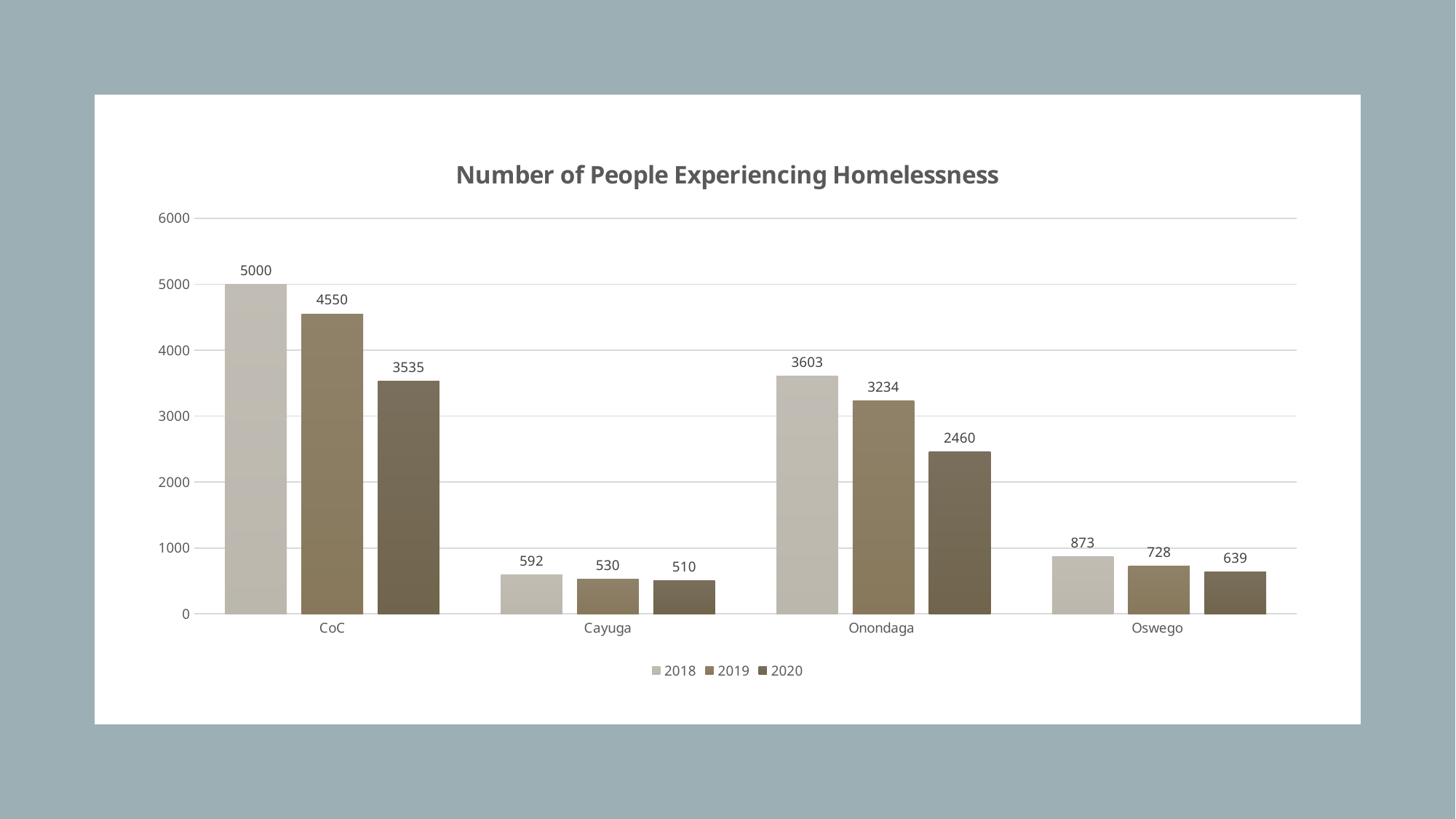
What is the value for CoC in 2018? 5000 Which is larger, the 2019 value for Onondaga or the 2019 value for Oswego? Onondaga How many categories are shown on the x axis? 4 Which category has the lowest value in 2020? Cayuga What is the value for Onondaga in 2020? 2460 Which category has the highest value in 2018? CoC What kind of chart is shown on the slide? bar chart How many series does the legend list? 3 What is the value for Oswego in 2019? 728 Is the 2018 value for Onondaga greater or less than 3000? greater What is the difference between the 2018 and 2020 values for CoC? 1465 What is the title of the chart? Number of People Experiencing Homelessness